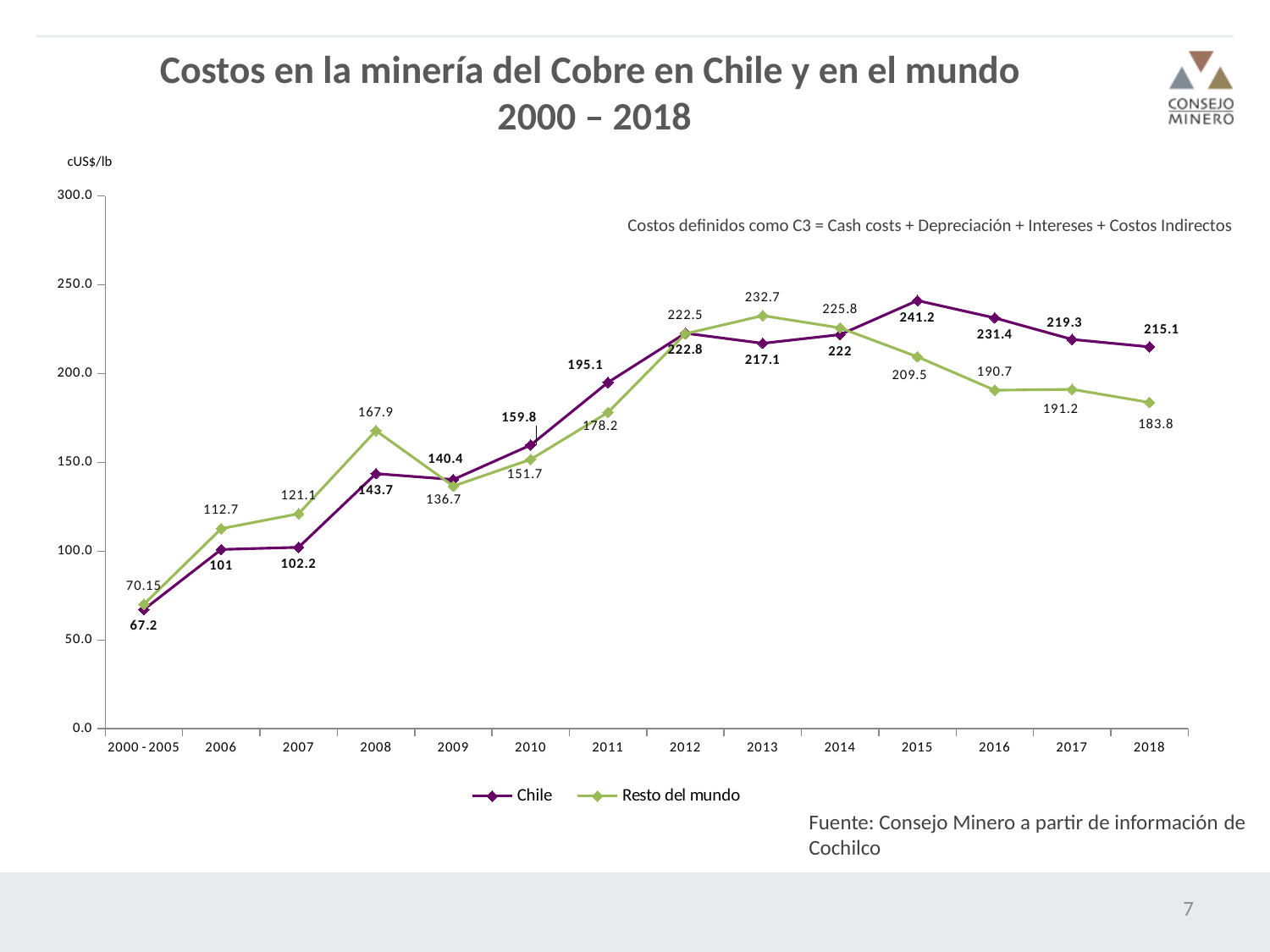
What unit is shown above the y axis? cUS$/lb In which year does the Resto del mundo series reach its highest value? 2013 What type of chart is shown on the slide? Line chart How many series does the legend list? 2 Do the Chile values rise or fall from 2015 to 2018? Fall What is the difference between Chile and Resto del mundo in 2018? 31.3 How many time periods are plotted along the x axis? 14 What is the value for Chile in 2000 - 2005? 67.2 What is the value for Chile in 2018? 215.1 What is the value for Resto del mundo in 2008? 167.9 In which year does the Chile series reach its highest value? 2015 In 2013, which series has the higher value, Chile or Resto del mundo? Resto del mundo